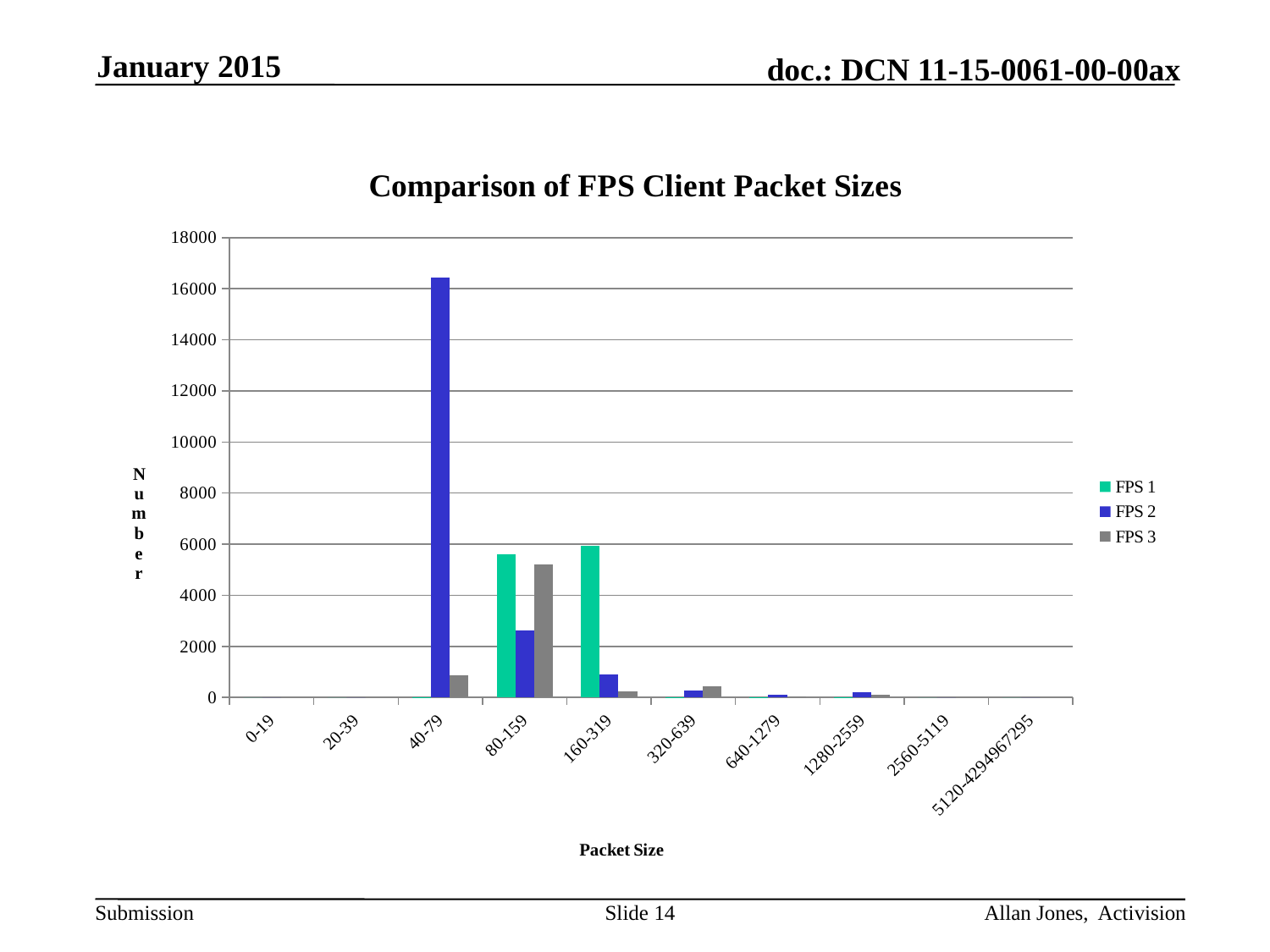
Which packet size category has the highest FPS 2 bar? 40-79 For packet size 80-159, which is larger, the FPS 1 value or the FPS 2 value? FPS 1 Is the FPS 3 value for packet size 40-79 greater or less than 2000? less How many series does the legend list? 3 For packet size 40-79, which is larger, the FPS 2 value or the FPS 3 value? FPS 2 Is the FPS 1 value for packet size 80-159 greater or less than 4000? greater How many packet size categories are shown on the x axis? 10 What kind of chart is shown on the slide? bar chart Which packet size category has the highest FPS 3 bar? 80-159 What is the title of the chart? Comparison of FPS Client Packet Sizes Is the FPS 2 value for packet size 80-159 greater or less than 2000? greater